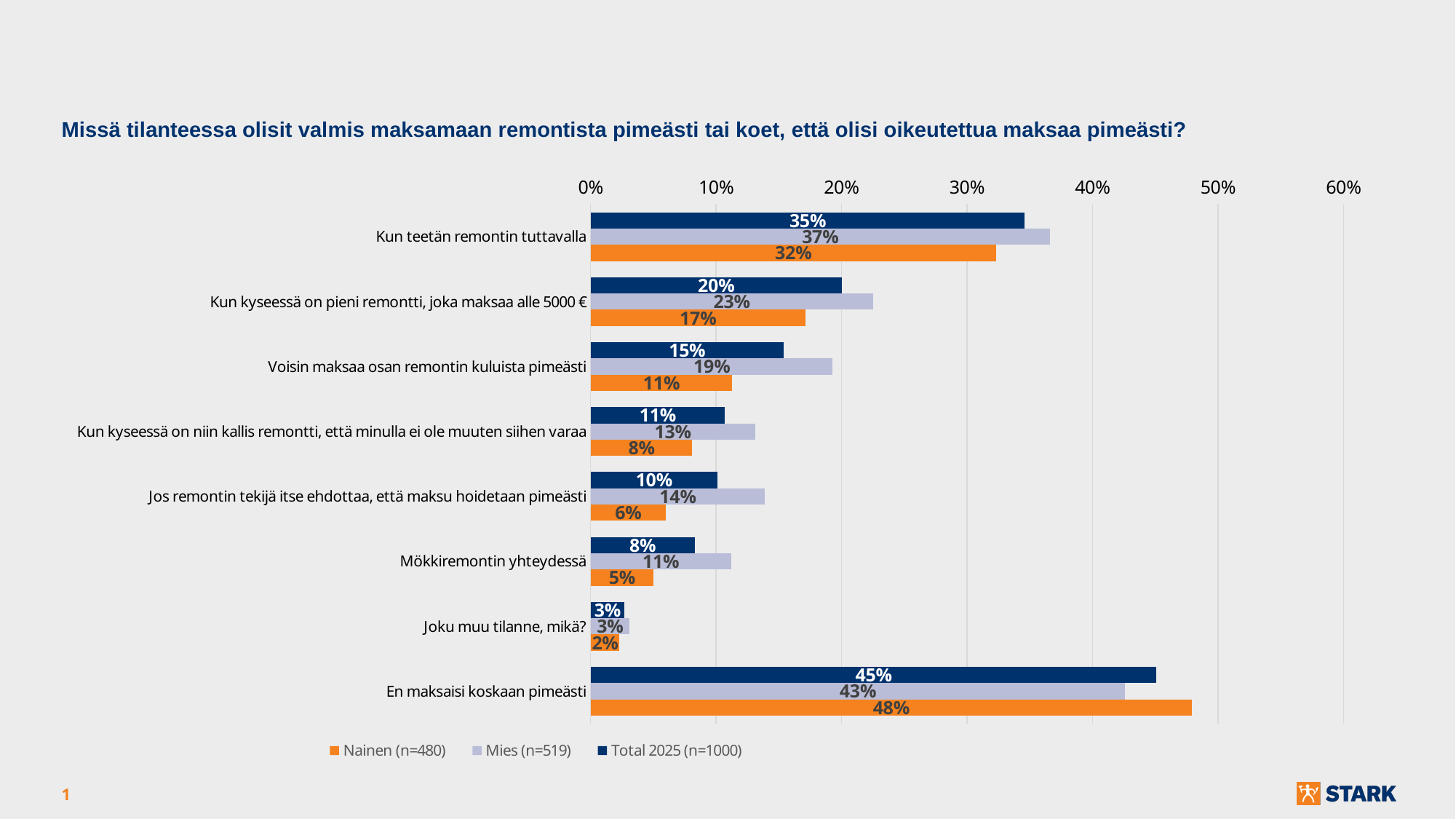
Which category has the highest Total 2025 (n=1000) value? En maksaisi koskaan pimeästi How many categories are shown on the chart? 8 For "Mökkiremontin yhteydessä", which is larger: the Mies (n=519) value or the Nainen (n=480) value? Mies (n=519) What is the difference between the Mies (n=519) and Nainen (n=480) values for "Kun kyseessä on pieni remontti, joka maksaa alle 5000 €"? 6% What is the Mies (n=519) value for "Jos remontin tekijä itse ehdottaa, että maksu hoidetaan pimeästi"? 14% How many series does the legend list? 3 Is the Total 2025 (n=1000) value for "Voisin maksaa osan remontin kuluista pimeästi" greater or less than 10%? greater What is the Nainen (n=480) value for "En maksaisi koskaan pimeästi"? 48% Which category has the lowest Nainen (n=480) value? Joku muu tilanne, mikä? What kind of chart is shown on the slide? Bar chart Which colour represents the Nainen (n=480) series? Orange What is the Total 2025 (n=1000) value for "Kun teetän remontin tuttavalla"? 35%